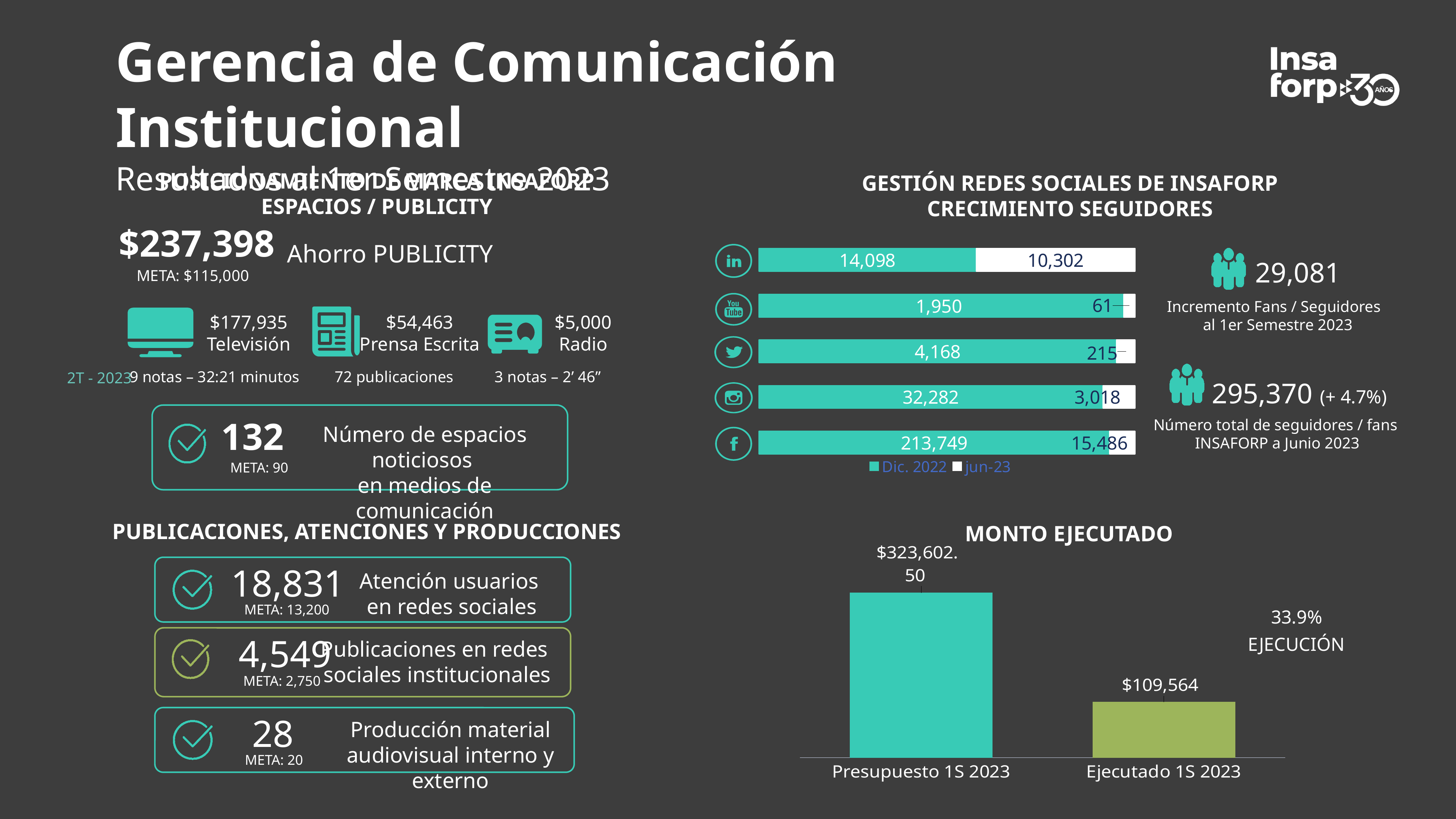
In the GESTIÓN REDES SOCIALES DE INSAFORP CRECIMIENTO SEGUIDORES chart, which bar has the highest Dic. 2022 value? the bottom bar (Facebook icon) In the GESTIÓN REDES SOCIALES DE INSAFORP CRECIMIENTO SEGUIDORES chart, what is the total of the top bar (LinkedIn icon) across both series? 24,400 In the MONTO EJECUTADO chart, what is the value for Presupuesto 1S 2023? $323,602.50 In the MONTO EJECUTADO chart, what kind of chart is shown? bar chart In the GESTIÓN REDES SOCIALES DE INSAFORP CRECIMIENTO SEGUIDORES chart, what is the Dic. 2022 value for the bottom bar (Facebook icon)? 213,749 In the MONTO EJECUTADO chart, how many bars are plotted? 2 In the GESTIÓN REDES SOCIALES DE INSAFORP CRECIMIENTO SEGUIDORES chart, how many series does the legend list? 2 In the GESTIÓN REDES SOCIALES DE INSAFORP CRECIMIENTO SEGUIDORES chart, what are the two legend entries? Dic. 2022 and jun-23 In the MONTO EJECUTADO chart, what is the value for Ejecutado 1S 2023? $109,564 In the MONTO EJECUTADO chart, which is larger, Presupuesto 1S 2023 or Ejecutado 1S 2023? Presupuesto 1S 2023 In the GESTIÓN REDES SOCIALES DE INSAFORP CRECIMIENTO SEGUIDORES chart, what is the jun-23 value for the top bar (LinkedIn icon)? 10,302 In the MONTO EJECUTADO chart, what is the difference between Presupuesto 1S 2023 and Ejecutado 1S 2023? $214,038.50